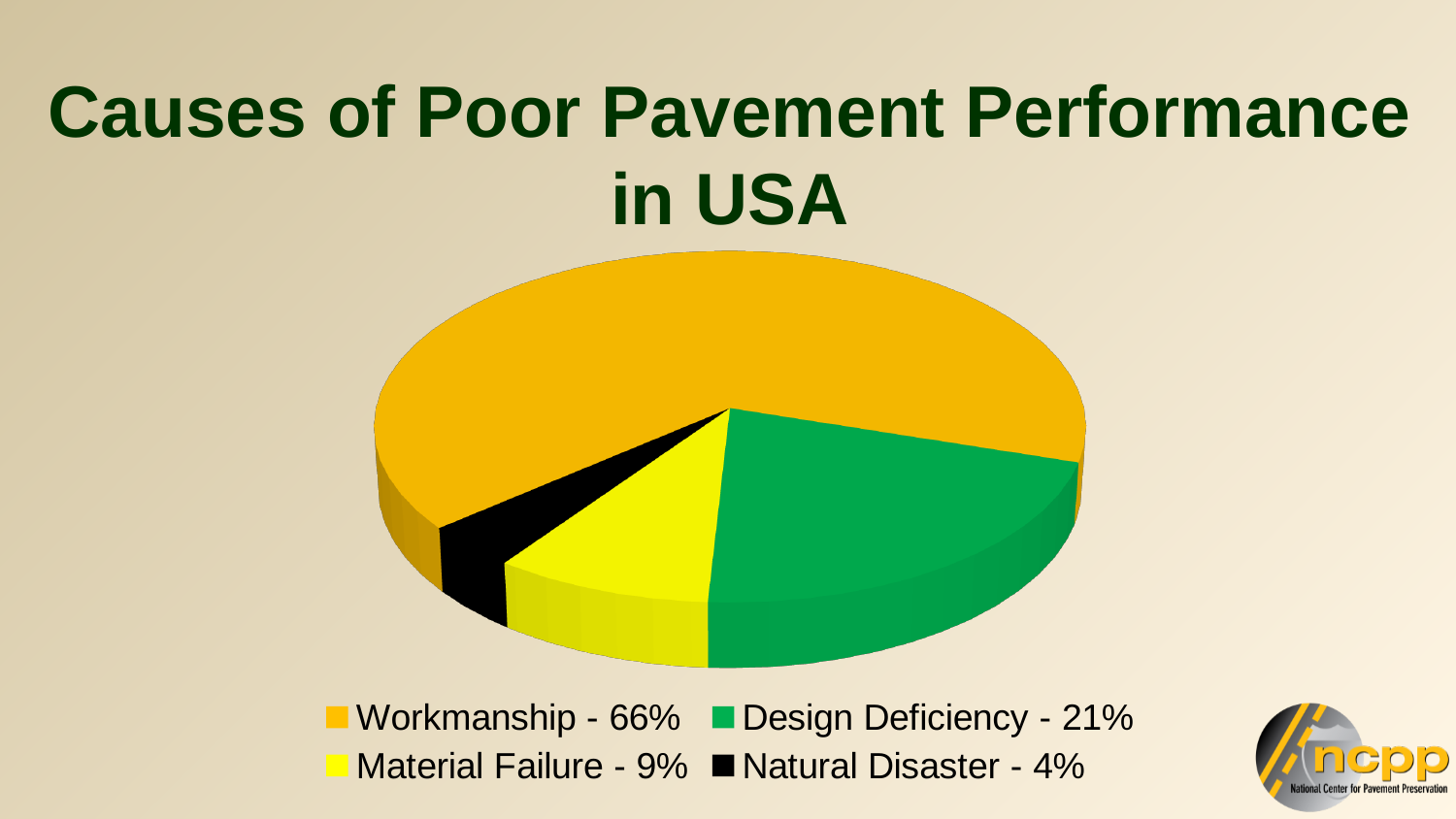
What share of poor pavement performance is attributed to Natural Disaster? 4% What is the difference in percentage points between Material Failure and Natural Disaster? 5 What share of poor pavement performance is attributed to Design Deficiency? 21% Which is larger, the share for Design Deficiency or the share for Material Failure? Design Deficiency Which cause accounts for the smallest share of the pie? Natural Disaster What colour represents Natural Disaster in the chart? Black What is the difference in percentage points between Workmanship and Design Deficiency? 45 What share of poor pavement performance is attributed to Workmanship? 66% How many causes are shown in the pie chart? 4 What kind of chart is shown on the slide? Pie chart Which cause accounts for the largest share of the pie? Workmanship